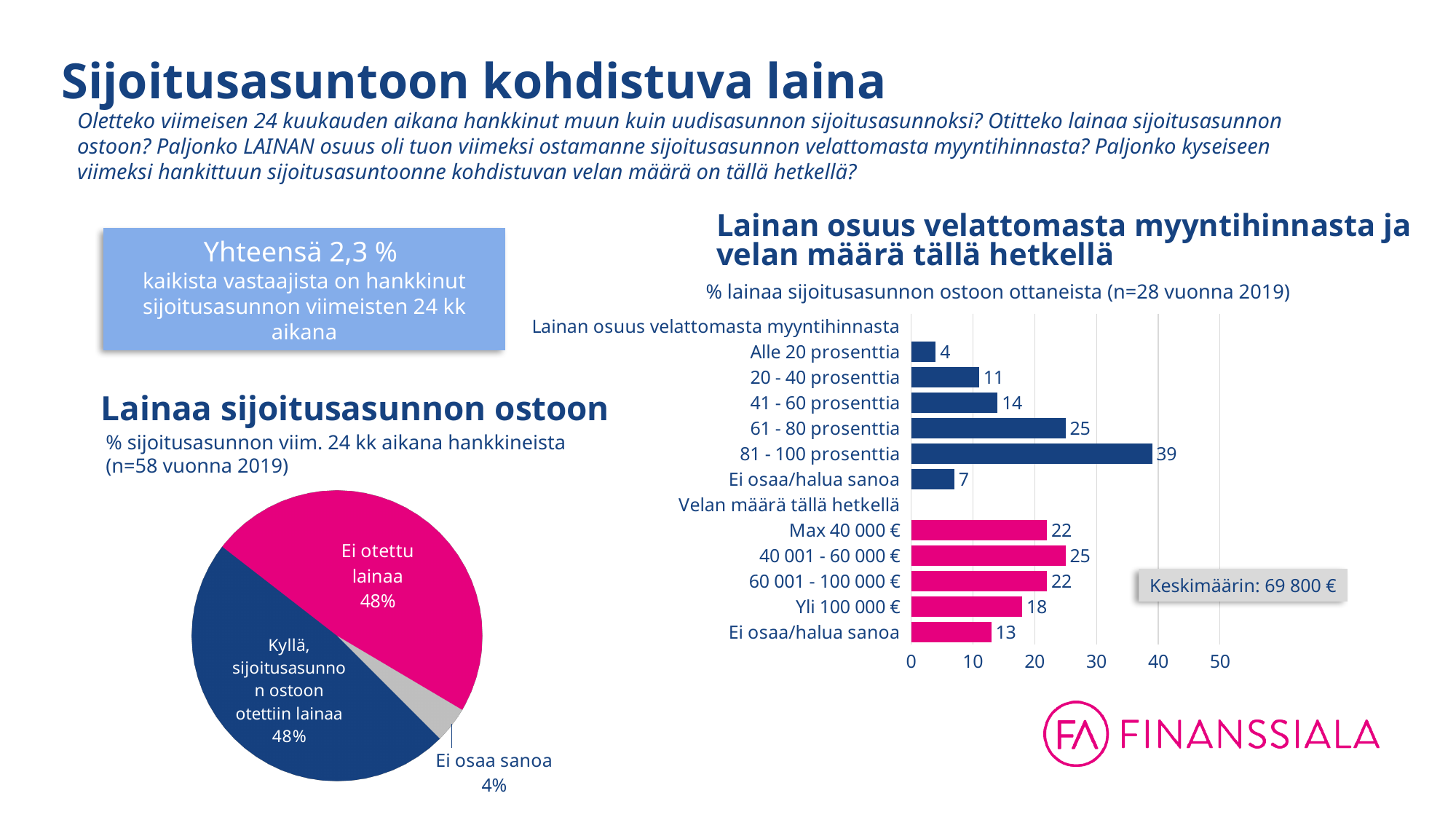
In the 'Lainan osuus velattomasta myyntihinnasta ja velan määrä tällä hetkellä' chart, what is the value for '81 - 100 prosenttia'? 39 In the 'Lainan osuus velattomasta myyntihinnasta ja velan määrä tällä hetkellä' chart, what is the difference between '81 - 100 prosenttia' and '61 - 80 prosenttia'? 14 What kind of chart is 'Lainan osuus velattomasta myyntihinnasta ja velan määrä tällä hetkellä'? Bar chart In the 'Lainan osuus velattomasta myyntihinnasta ja velan määrä tällä hetkellä' chart, which is larger: '40 001 - 60 000 €' or 'Yli 100 000 €'? 40 001 - 60 000 € In the 'Lainaa sijoitusasunnon ostoon' pie chart, what share is labelled 'Ei otettu lainaa'? 48% What average debt amount is shown in the box next to the 'Lainan osuus velattomasta myyntihinnasta ja velan määrä tällä hetkellä' chart? 69 800 € What kind of chart is 'Lainaa sijoitusasunnon ostoon'? Pie chart In the 'Lainan osuus velattomasta myyntihinnasta ja velan määrä tällä hetkellä' chart, which category under 'Lainan osuus velattomasta myyntihinnasta' has the highest value? 81 - 100 prosenttia In the 'Lainan osuus velattomasta myyntihinnasta ja velan määrä tällä hetkellä' chart, what is the value for 'Max 40 000 €'? 22 In the 'Lainaa sijoitusasunnon ostoon' pie chart, what share is labelled 'Ei osaa sanoa'? 4% In the 'Lainan osuus velattomasta myyntihinnasta ja velan määrä tällä hetkellä' chart, which category under 'Lainan osuus velattomasta myyntihinnasta' has the lowest value? Alle 20 prosenttia How many slices does the 'Lainaa sijoitusasunnon ostoon' pie chart have? 3